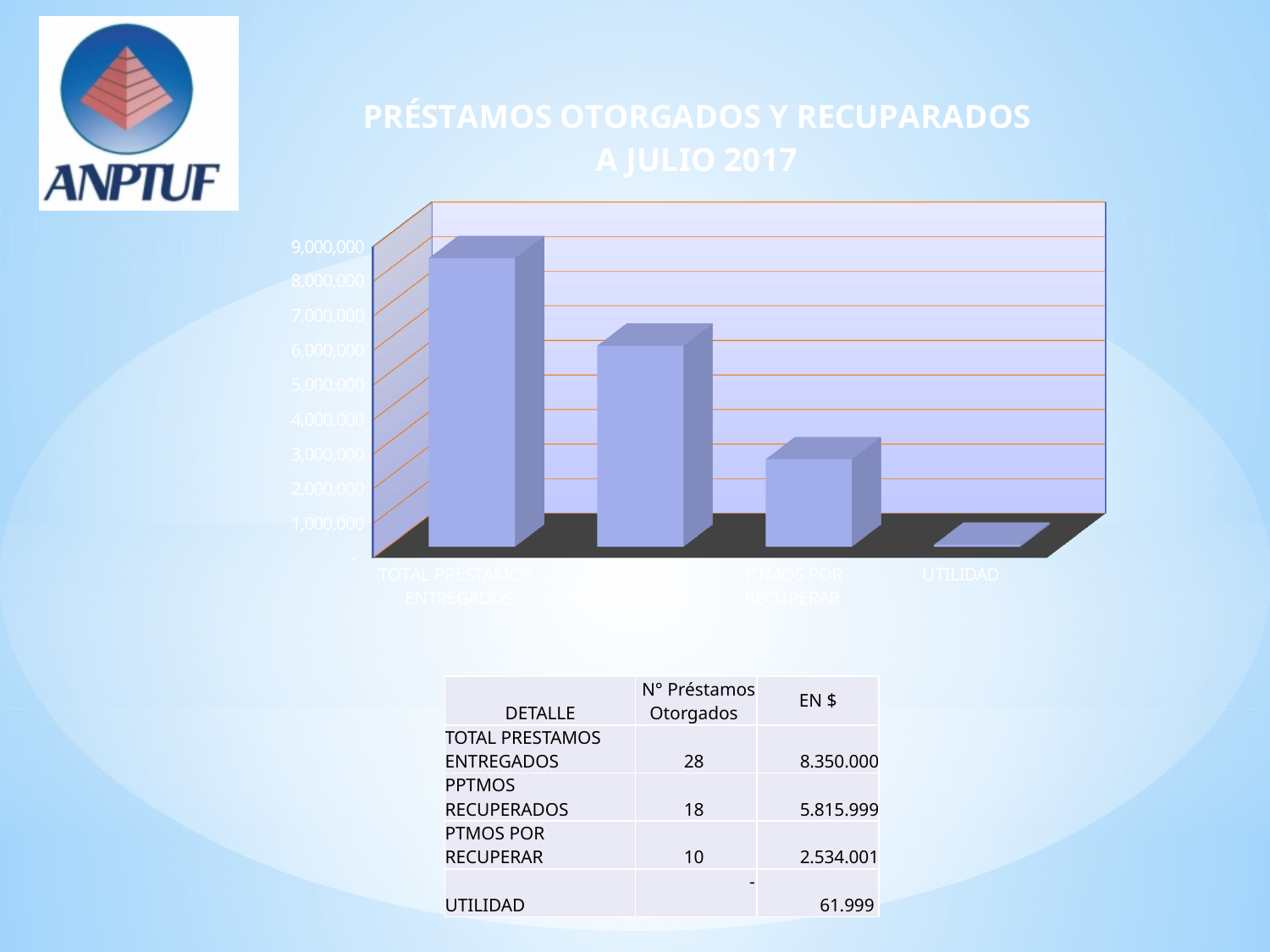
Do the bar values rise or fall from left to right across the chart? fall What kind of chart is shown on the slide? bar chart Which is larger, the bar for PPTMOS RECUPERADOS or the bar for PTMOS POR RECUPERAR? PPTMOS RECUPERADOS Which category has the lowest bar in the chart? UTILIDAD Which category has the highest bar in the chart? TOTAL PRESTAMOS ENTREGADOS What is the highest value labelled on the vertical axis of the chart? 9,000,000 Is the value for PTMOS POR RECUPERAR greater or less than 3,000,000? less Is the value for TOTAL PRESTAMOS ENTREGADOS greater or less than 8,000,000? greater What is the title of the chart? PRÉSTAMOS OTORGADOS Y RECUPARADOS A JULIO 2017 How many categories are plotted in the chart? 4 Is the value for UTILIDAD greater or less than 1,000,000? less